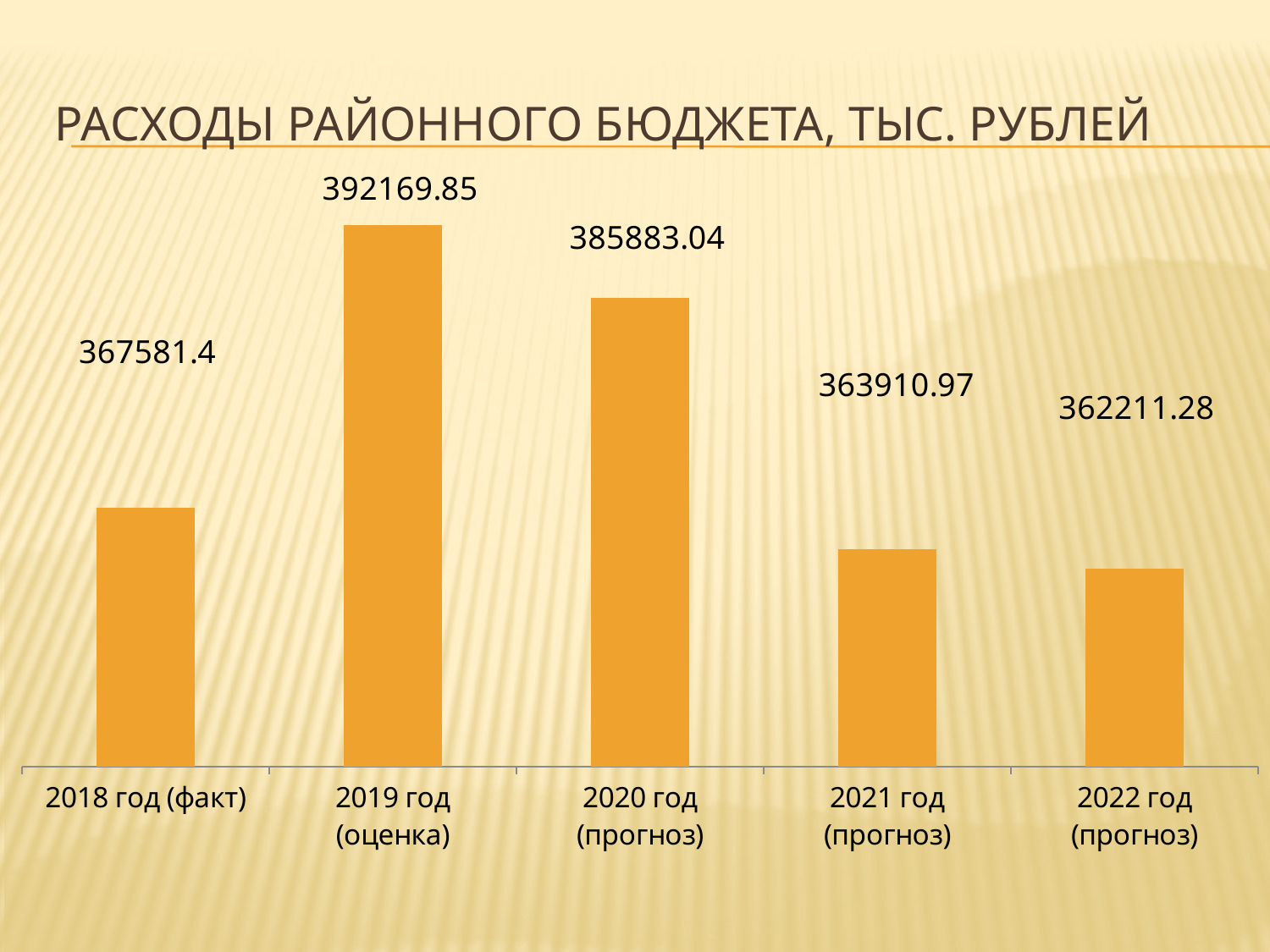
What is the difference between the values for 2019 год (оценка) and 2020 год (прогноз)? 6286.81 What is the value for 2020 год (прогноз)? 385883.04 Which is larger, the value for 2018 год (факт) or the value for 2021 год (прогноз)? 2018 год (факт) Which year has the highest value? 2019 год (оценка) How many bars are shown in the chart? 5 What is the value for 2019 год (оценка)? 392169.85 Which year has the lowest value? 2022 год (прогноз) What is the difference between the values for 2021 год (прогноз) and 2022 год (прогноз)? 1699.69 Do the values rise or fall from 2019 год (оценка) to 2022 год (прогноз)? Fall What is the value for 2018 год (факт)? 367581.4 What kind of chart is shown on the slide? Bar chart What is the value for 2022 год (прогноз)? 362211.28